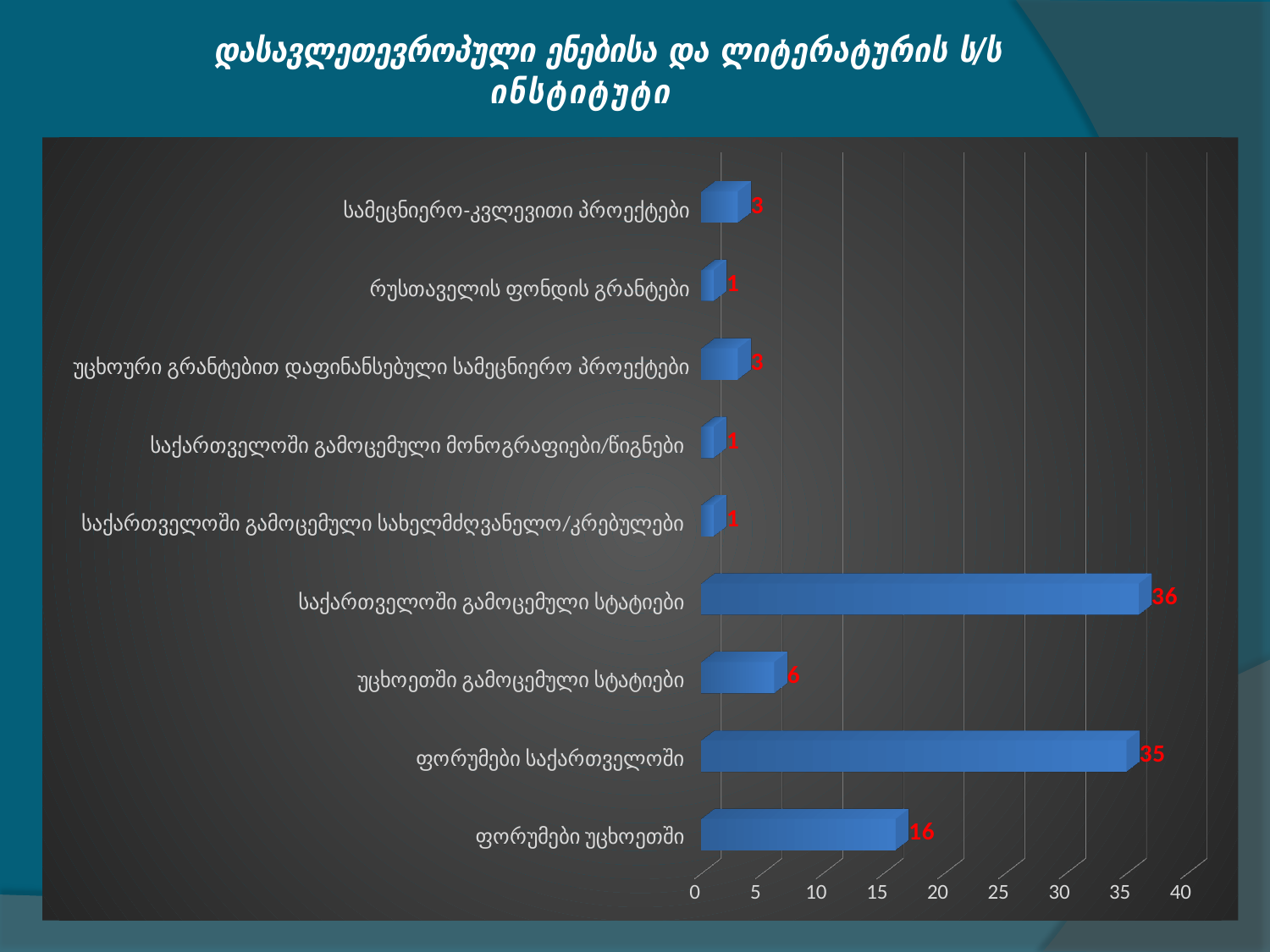
What is the difference between the values for ფორუმები საქართველოში and ფორუმები უცხოეთში? 19 Is the value for ფორუმები საქართველოში greater or less than 30? greater Which category has the highest value? საქართველოში გამოცემული სტატიები What is the value for უცხოეთში გამოცემული სტატიები? 6 What is the value for რუსთაველის ფონდის გრანტები? 1 What is the maximum value shown on the horizontal axis? 40 Which is larger: the value for სამეცნიერო-კვლევითი პროექტები or the value for უცხოეთში გამოცემული სტატიები? უცხოეთში გამოცემული სტატიები What is the title of the slide? დასავლეთევროპული ენებისა და ლიტერატურის ს/ს ინსტიტუტი How many categories are plotted in the chart? 9 What type of chart is shown on the slide? bar chart What is the value for საქართველოში გამოცემული სტატიები? 36 What is the value for ფორუმები უცხოეთში? 16